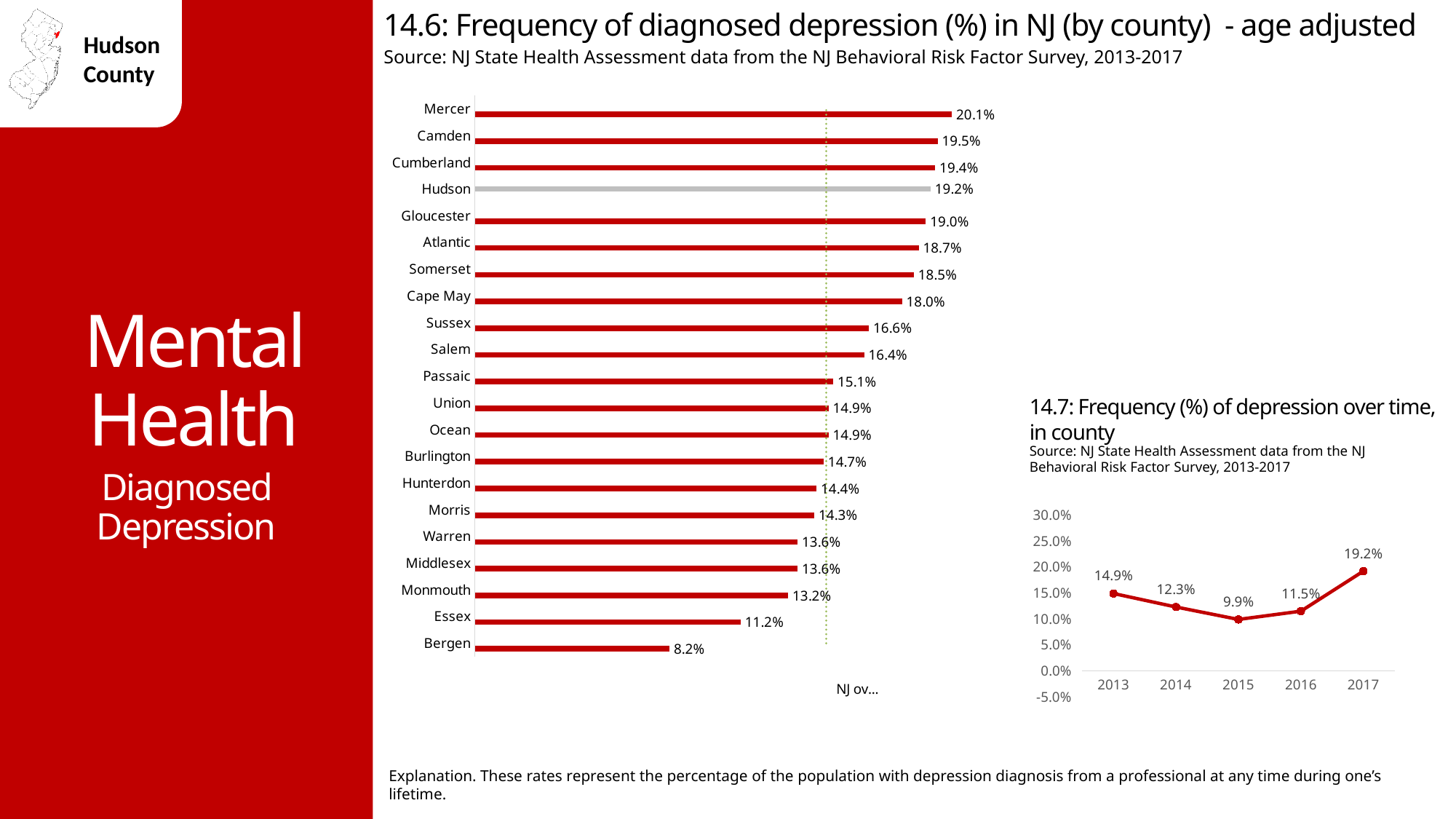
In the chart 14.6 (frequency of diagnosed depression by county), which is larger, the value for Essex or the value for Monmouth? Monmouth In the chart 14.6 (frequency of diagnosed depression by county), what is the difference between Mercer and Bergen? 11.9% In the chart 14.6 (frequency of diagnosed depression by county), what is the value for Cape May? 18.0% In the chart 14.6 (frequency of diagnosed depression by county), what is the value for Hudson? 19.2% In the chart 14.7 (frequency of depression over time), which year has the highest value? 2017 In the chart 14.6 (frequency of diagnosed depression by county), how many counties are shown? 21 In the chart 14.7 (frequency of depression over time), what is the difference between the 2017 and 2013 values? 4.3% In the chart 14.7 (frequency of depression over time), what is the value for 2015? 9.9% In the chart 14.6 (frequency of diagnosed depression by county), which county has the highest value? Mercer In the chart 14.6 (frequency of diagnosed depression by county), which county has the lowest value? Bergen In the chart 14.7 (frequency of depression over time), how many years are plotted? 5 What kind of chart is chart 14.6 (frequency of diagnosed depression by county)? Bar chart